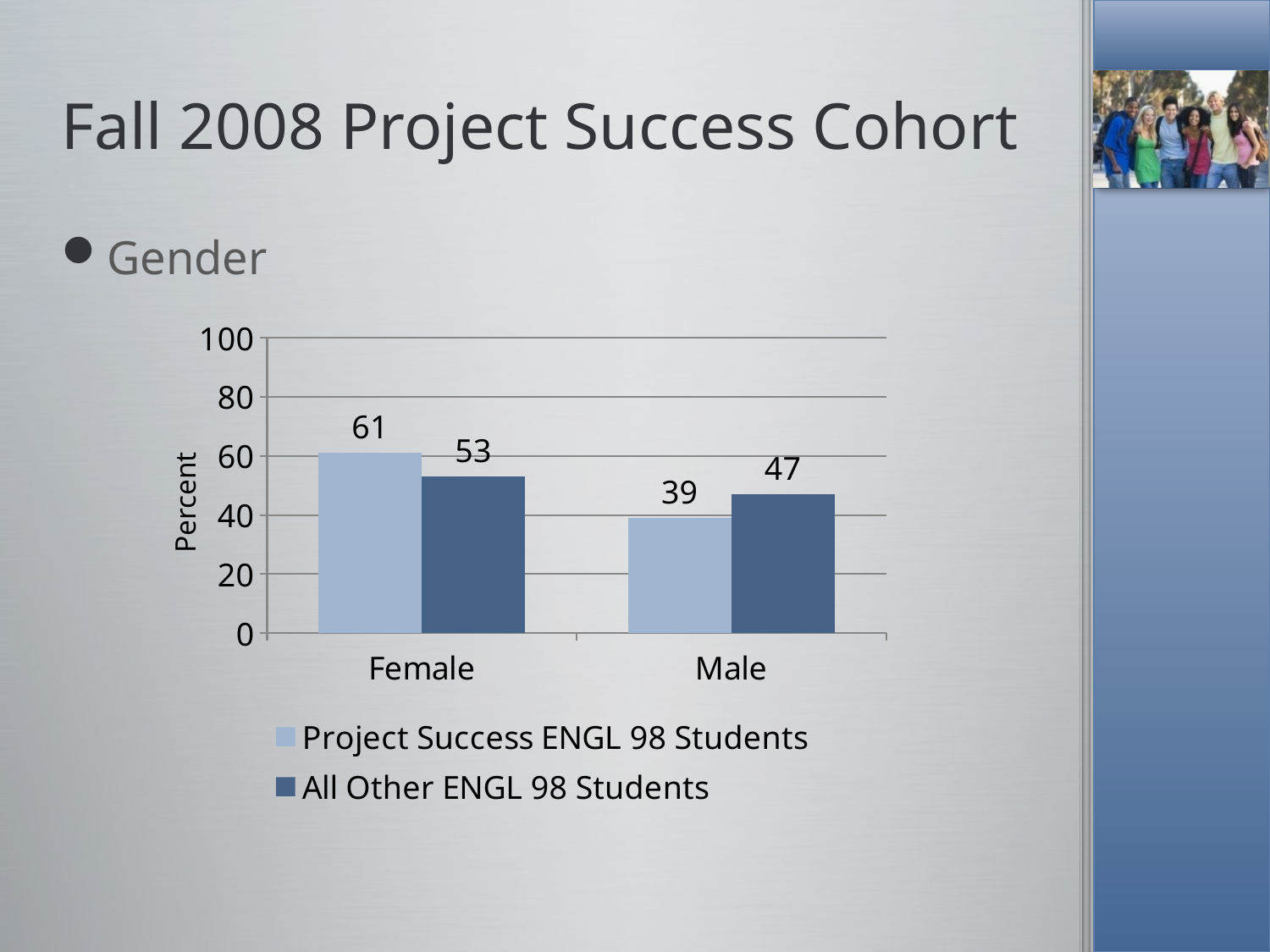
How many series does the legend list? 2 What is the label of the vertical axis? Percent What is the difference between the Female values for Project Success ENGL 98 Students and All Other ENGL 98 Students? 8 What is the value for Female in the Project Success ENGL 98 Students series? 61 What kind of chart is shown on the slide? Bar chart For Male, which series has the larger value: Project Success ENGL 98 Students or All Other ENGL 98 Students? All Other ENGL 98 Students What is the value for Female in the All Other ENGL 98 Students series? 53 What is the value for Male in the All Other ENGL 98 Students series? 47 How many categories are shown on the x axis? 2 What is the value for Male in the Project Success ENGL 98 Students series? 39 Which category has the highest value in the Project Success ENGL 98 Students series? Female Which category has the lowest value in the All Other ENGL 98 Students series? Male